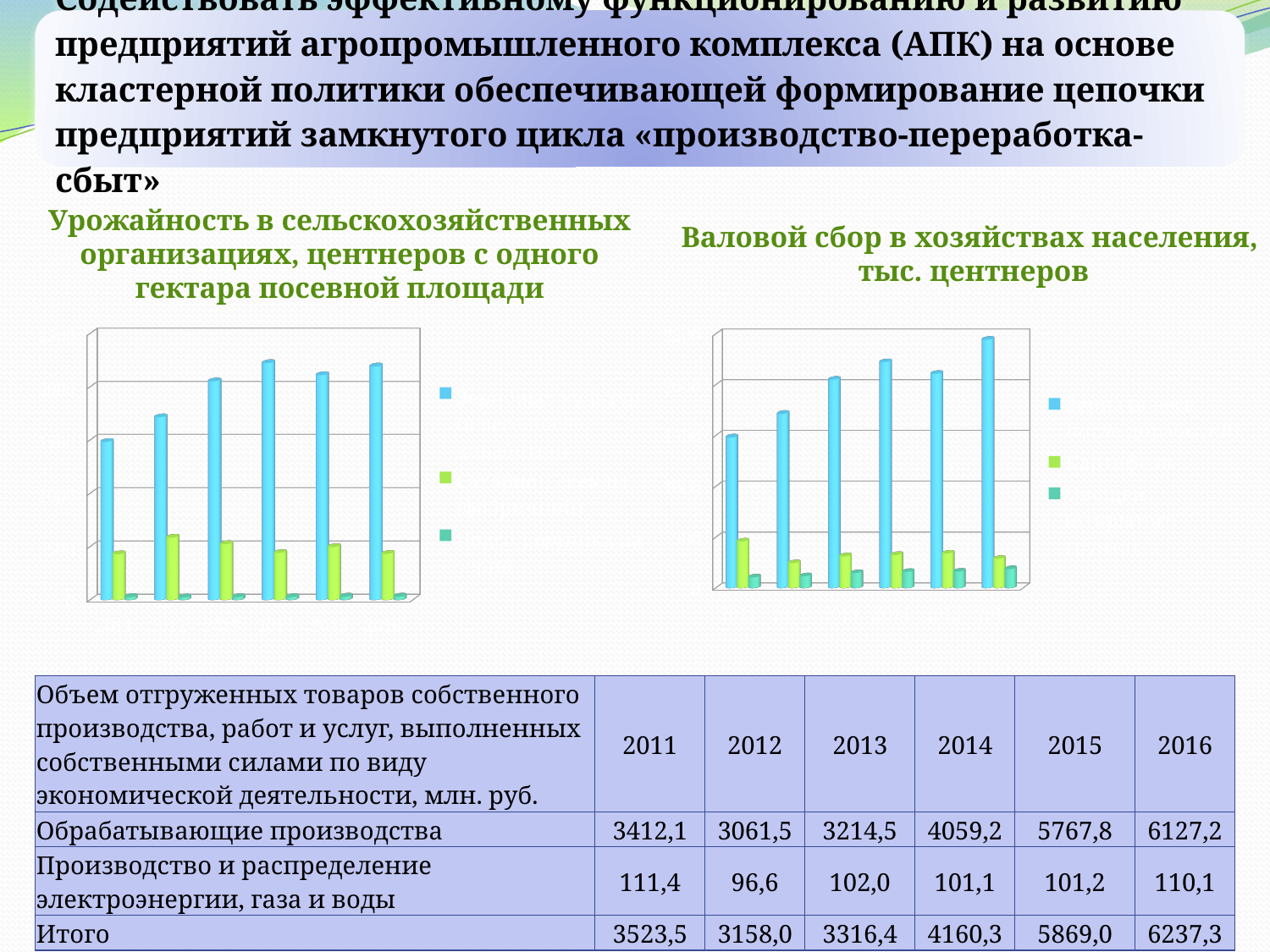
In the right chart (Валовой сбор в хозяйствах населения), are the light green bars taller or shorter than the blue bars? shorter In the left chart (Урожайность в сельскохозяйственных организациях), how many groups of bars are plotted along the x axis? 6 In the right chart (Валовой сбор в хозяйствах населения), do the blue bars generally rise or fall from left to right along the x axis? rise What is the title of the chart on the left side of the slide? Урожайность в сельскохозяйственных организациях, центнеров с одного гектара посевной площади In the left chart (Урожайность в сельскохозяйственных организациях), which colour series has the shortest bars? teal (the third series) What kind of chart is the chart titled "Урожайность в сельскохозяйственных организациях, центнеров с одного гектара посевной площади"? bar chart What kind of chart is the chart titled "Валовой сбор в хозяйствах населения, тыс. центнеров"? bar chart In the right chart (Валовой сбор в хозяйствах населения), how many groups of bars are plotted along the x axis? 6 In the left chart (Урожайность в сельскохозяйственных организациях), how many series does the legend list? 3 What is the title of the chart on the right side of the slide? Валовой сбор в хозяйствах населения, тыс. центнеров In the left chart (Урожайность в сельскохозяйственных организациях), are the blue bars taller or shorter than the green bars? taller In the right chart (Валовой сбор в хозяйствах населения), how many series does the legend list? 3